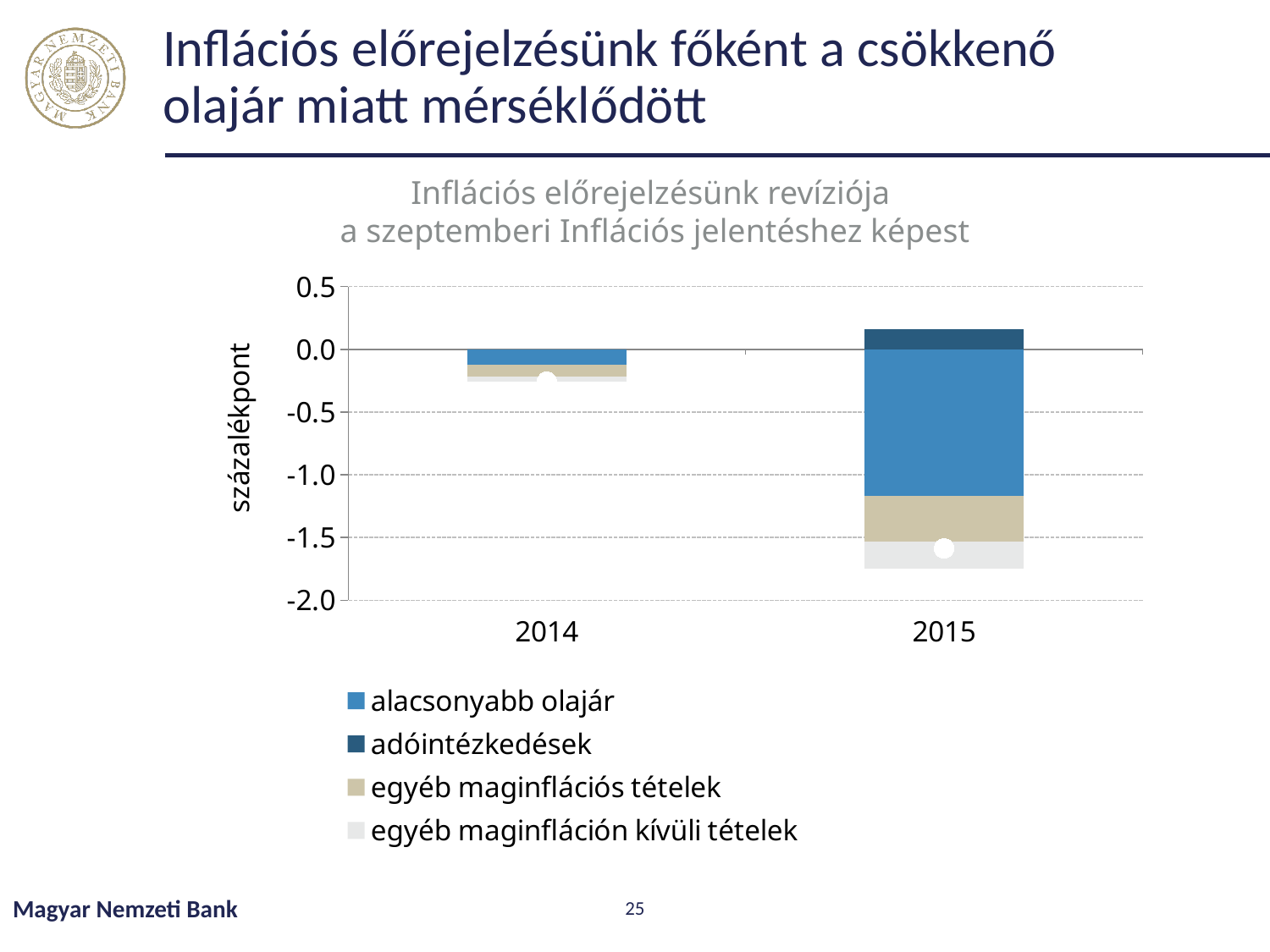
Do the total revisions rise or fall from 2014 to 2015? fall Is the total revision (white dot) for 2014 greater or less than -0.5? greater How many years (categories) are shown on the x axis? 2 What kind of chart is shown on the slide? stacked bar chart Which year shows the larger downward revision, 2014 or 2015? 2015 Is the contribution of 'alacsonyabb olajár' in 2015 greater or less than -1.0? less What unit is shown on the vertical axis label? százalékpont How many series does the legend list? 4 What is the title of the chart? Inflációs előrejelzésünk revíziója a szeptemberi Inflációs jelentéshez képest Which series contributes the largest part of the 2015 bar? alacsonyabb olajár Is the total revision (white dot) for 2015 greater or less than -1.5? less